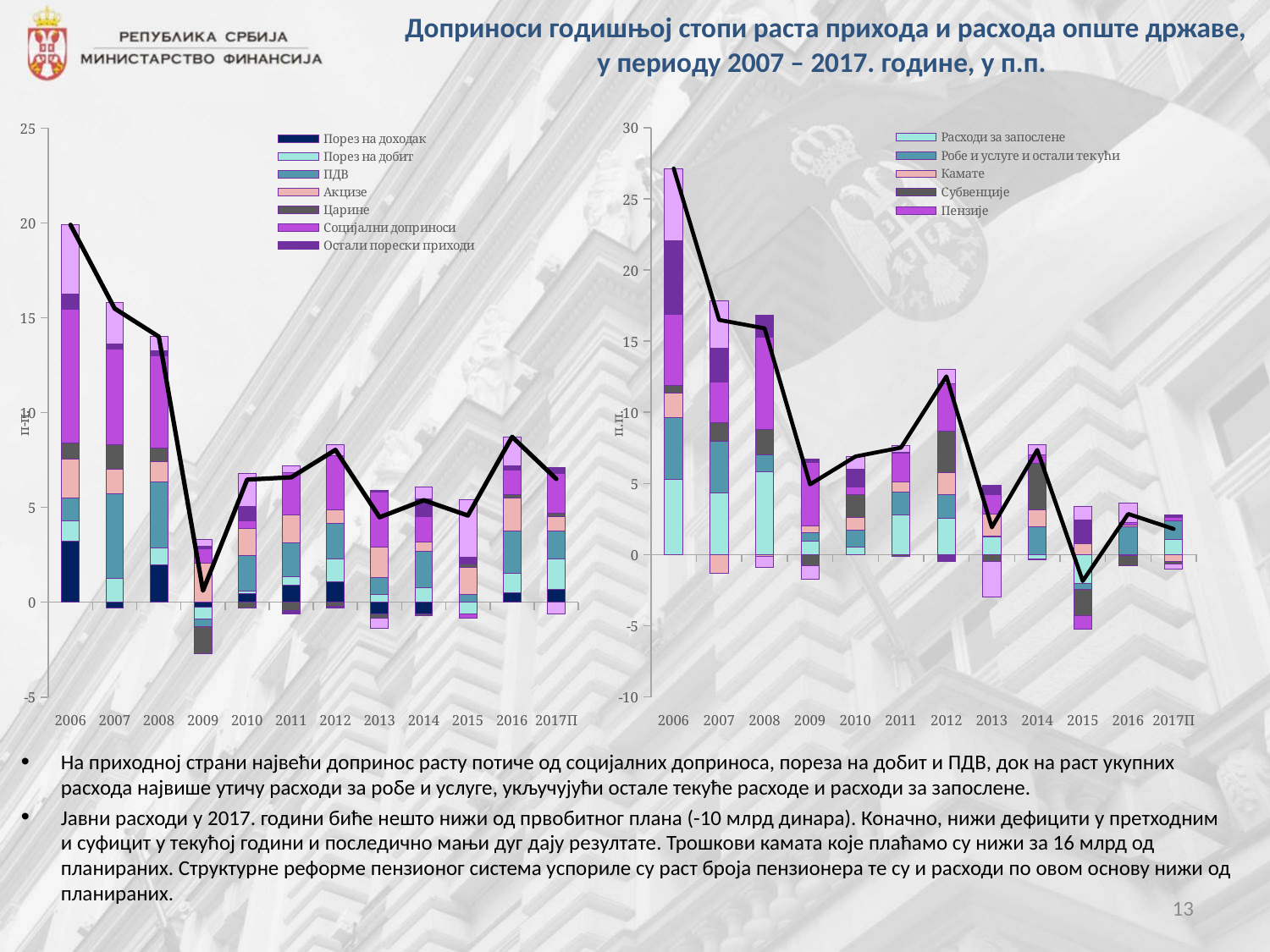
What is the first legend entry of the right chart? Расходи за запослене In the right chart, does the black line rise or fall from 2006 to 2009? fall How many series does the legend of the left chart list? 7 In the right chart, is the value of the black line for 2006 greater or less than 25? greater In the right chart, in which year does the black line reach its lowest value? 2015 In the left chart, in which year does the black line reach its highest value? 2006 What kind of chart is the left chart on the slide? stacked bar chart with a line In the left chart, in which year does the black line reach its lowest value? 2009 In the left chart, is the value of the black line for 2009 greater or less than 5? less How many series does the legend of the right chart list? 5 How many years (categories) are shown on the x axis of the left chart? 12 In the right chart, which year has the larger value of the black line, 2012 or 2013? 2012